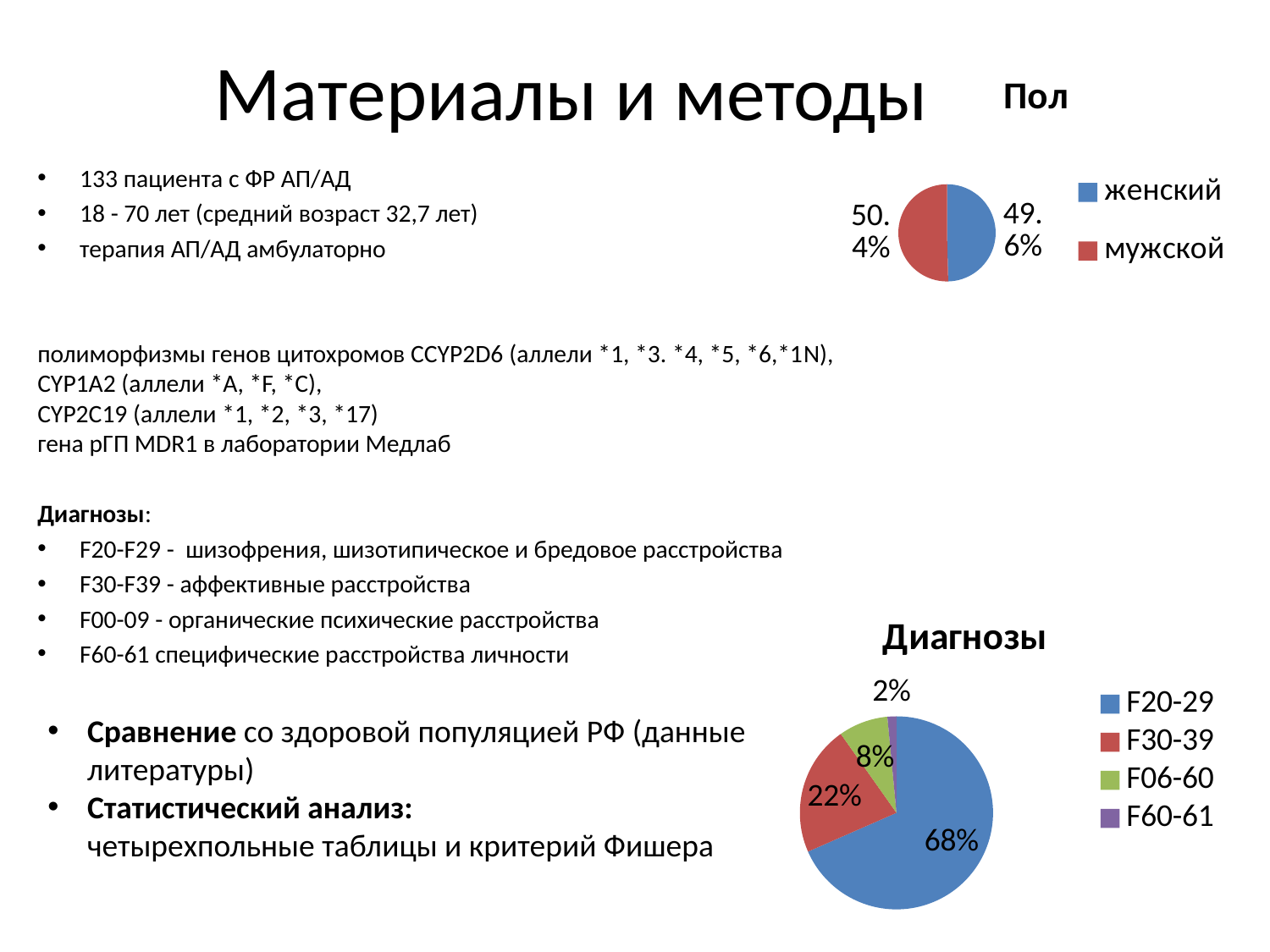
In the 'Диагнозы' chart, which category has the smallest slice? F60-61 In the 'Пол' chart, what share is labelled for мужской? 50.4% In the 'Диагнозы' chart, what share is labelled for F60-61? 2% In the 'Пол' chart, how many series does the legend list? 2 In the 'Диагнозы' chart, which category has the largest slice? F20-29 In the 'Пол' chart, what share is labelled for женский? 49.6% In the 'Диагнозы' chart, what share is labelled for F30-39? 22% In the 'Диагнозы' chart, what share is labelled for F20-29? 68% In the 'Диагнозы' chart, how many categories does the legend list? 4 In the 'Диагнозы' chart, what share is labelled for F06-60? 8% What kind of chart is the 'Пол' chart? pie chart In the 'Диагнозы' chart, what is the difference between the shares of F20-29 and F30-39? 46%